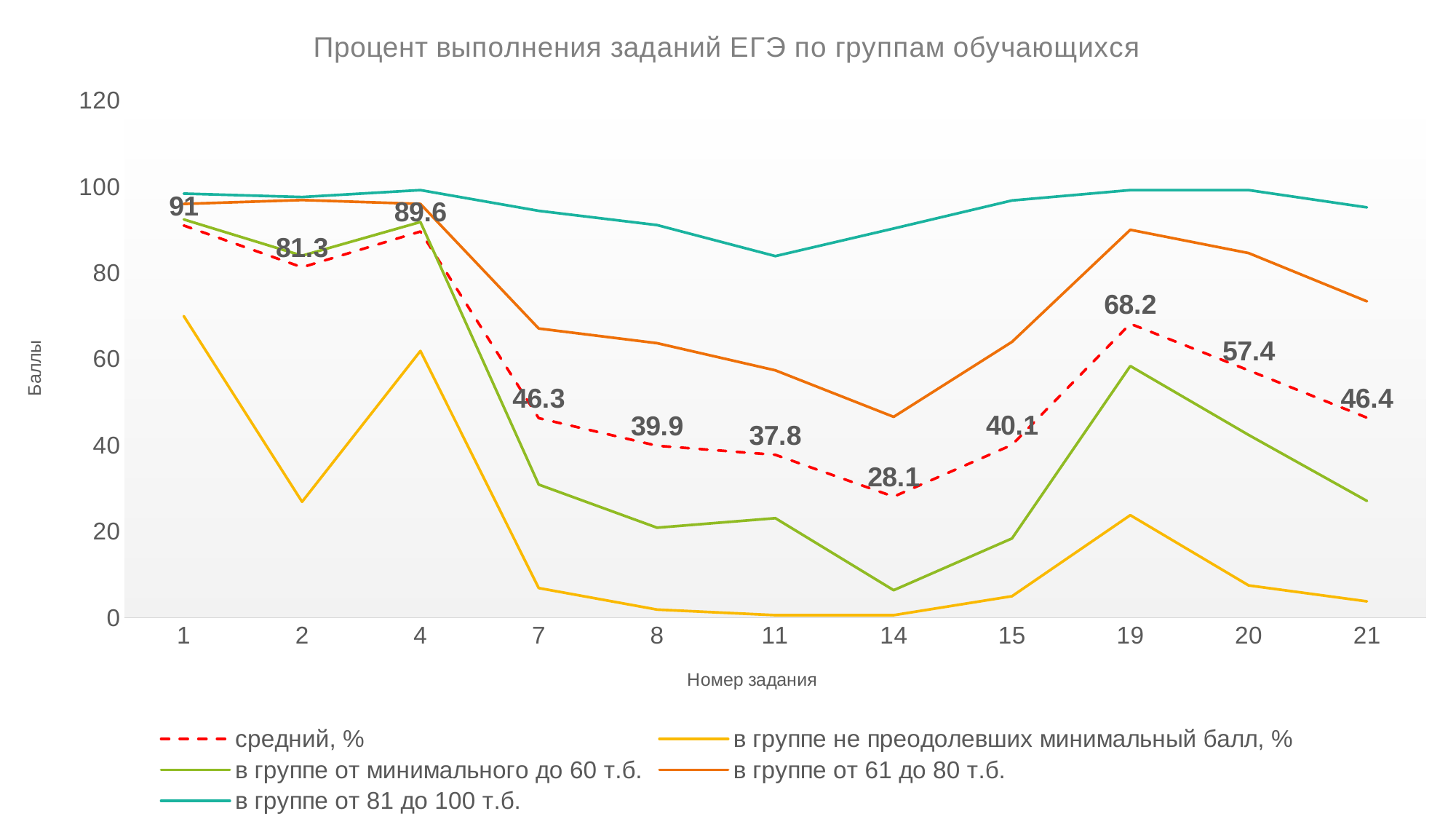
Does the 'средний, %' series rise or fall from task 4 to task 14? fall For which task number is the 'средний, %' series lowest? 14 What is the value of the 'средний, %' series for task 14? 28.1 For which task number is the 'средний, %' series highest? 1 What is the title of the chart? Процент выполнения заданий ЕГЭ по группам обучающихся How many series does the legend list? 5 What kind of chart is shown on the slide? line chart What is the difference between the 'средний, %' values for task 1 and task 2? 9.7 What is the value of the 'средний, %' series for task 19? 68.2 Which task has the larger 'средний, %' value, task 20 or task 21? 20 How many task numbers are plotted along the x axis? 11 Is the value for the 'в группе от 81 до 100 т.б.' series at task 11 greater or less than 80? greater